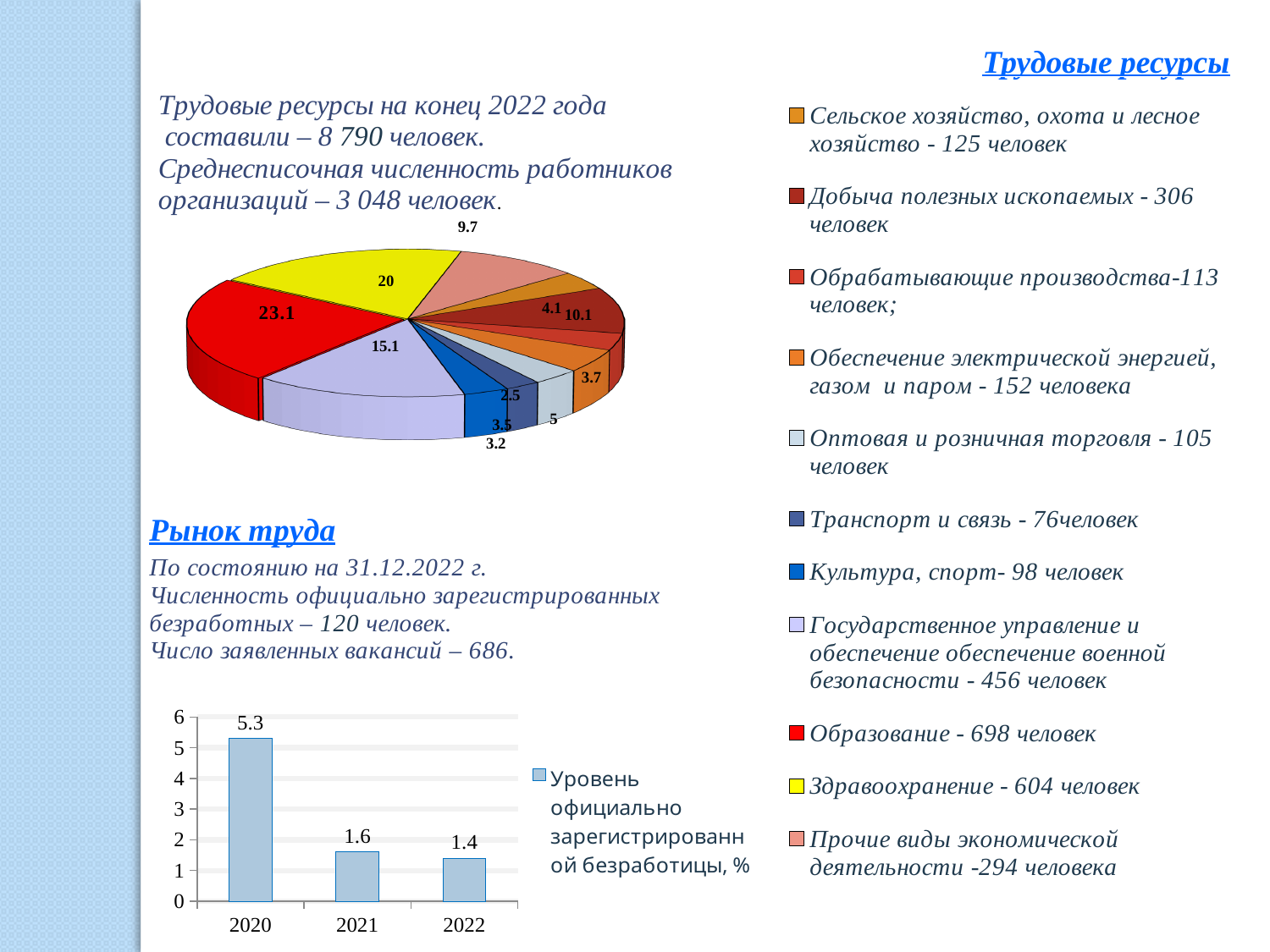
What kind of chart is the one in the upper left of the slide? pie chart What kind of chart is the one at the bottom left of the slide? bar chart In the pie chart in the upper left, what is the largest labelled value? 23.1 In the bar chart at the bottom left, how many years are shown on the x axis? 3 In the bar chart at the bottom left, which year has the lowest value? 2022 In the bar chart at the bottom left, do the values rise or fall from 2020 to 2022? fall In the bar chart at the bottom left, what is the value for 2022? 1.4 In the bar chart at the bottom left, how many series does the legend list? 1 In the bar chart at the bottom left, which year has the highest value? 2020 In the bar chart at the bottom left, what is the value for 2021? 1.6 In the bar chart at the bottom left, what is the difference between the values for 2020 and 2022? 3.9 In the bar chart at the bottom left, what is the value for 2020? 5.3